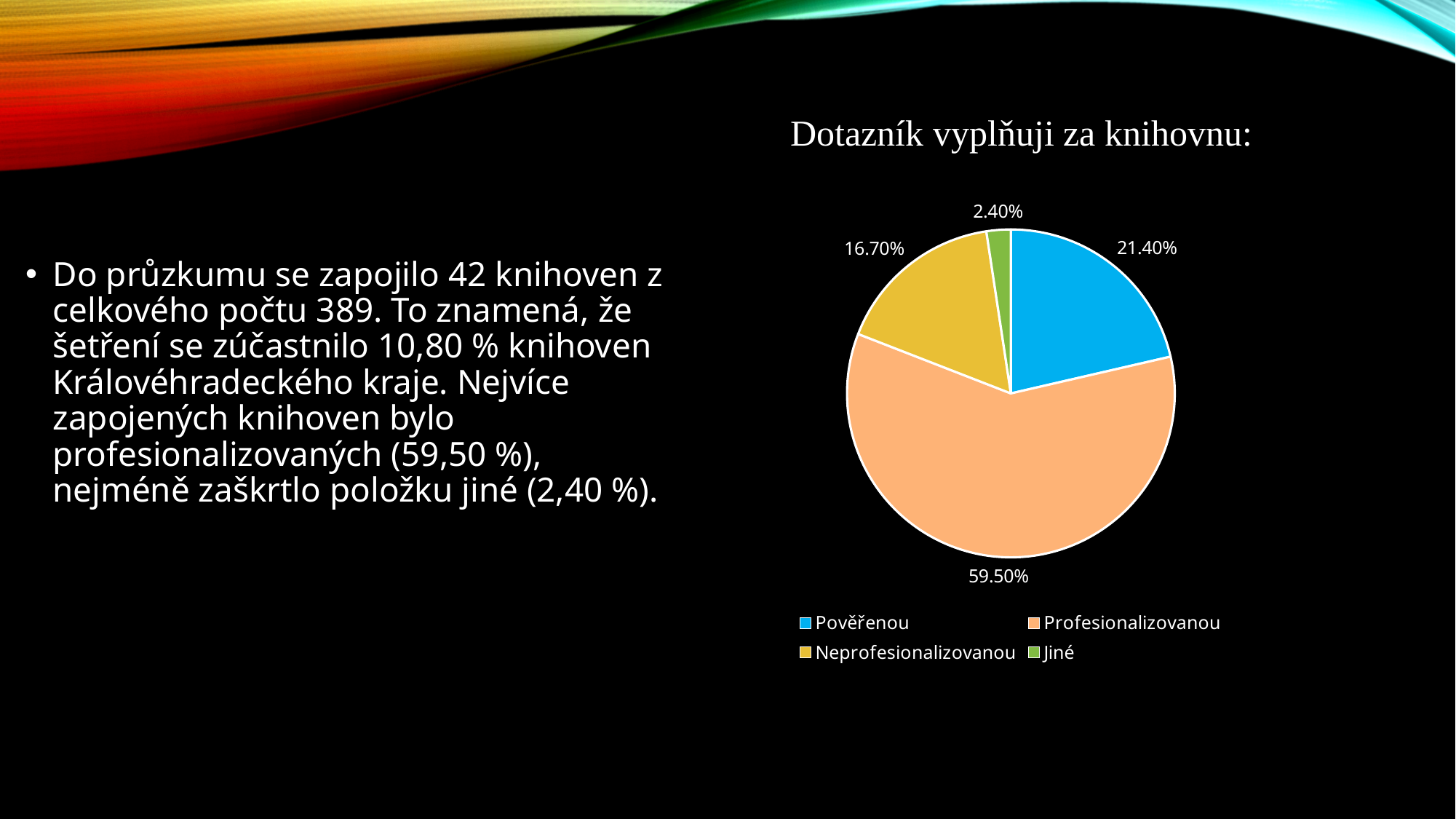
What is the title of the chart? Dotazník vyplňuji za knihovnu: What is the value for Jiné? 2.40% What is the difference between Profesionalizovanou and Pověřenou? 38.10% What is the value for Neprofesionalizovanou? 16.70% How many categories does the pie chart show? 4 What kind of chart is shown on the slide? pie chart Which category has the smallest slice? Jiné What is the value for Pověřenou? 21.40% What colour is the Jiné slice? green Which is larger, Pověřenou or Neprofesionalizovanou? Pověřenou What share of the pie does Profesionalizovanou have? 59.50% Which category has the largest slice? Profesionalizovanou